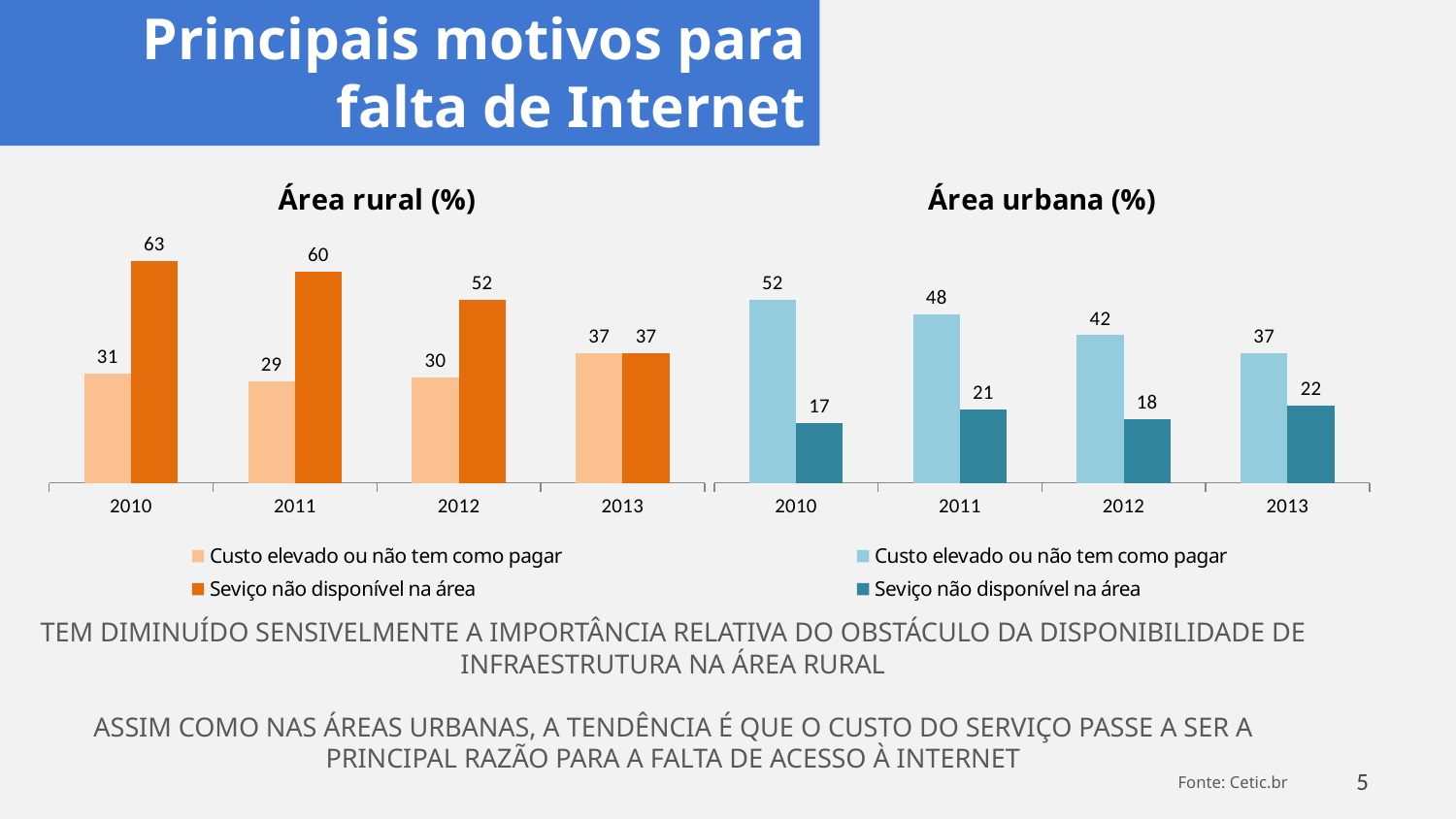
In the 'Área urbana (%)' chart, what is the difference between 'Custo elevado ou não tem como pagar' in 2010 and in 2013? 15 What is the title of the chart on the right side of the slide? Área urbana (%) In the 'Área rural (%)' chart, what is the value for 'Seviço não disponível na área' in 2010? 63 How many series does the legend of the 'Área urbana (%)' chart list? 2 In the 'Área urbana (%)' chart, which is larger in 2011: 'Custo elevado ou não tem como pagar' or 'Seviço não disponível na área'? Custo elevado ou não tem como pagar How many years are shown on the x axis of the 'Área rural (%)' chart? 4 In the 'Área rural (%)' chart, does the value for 'Seviço não disponível na área' rise or fall from 2010 to 2013? Fall In the 'Área rural (%)' chart, what is the difference between the two series in 2010? 32 In the 'Área rural (%)' chart, which year has the lowest value for 'Custo elevado ou não tem como pagar'? 2011 What kind of chart is the 'Área rural (%)' chart? Bar chart In the 'Área urbana (%)' chart, what is the value for 'Custo elevado ou não tem como pagar' in 2012? 42 In the 'Área urbana (%)' chart, which year has the highest value for 'Seviço não disponível na área'? 2013